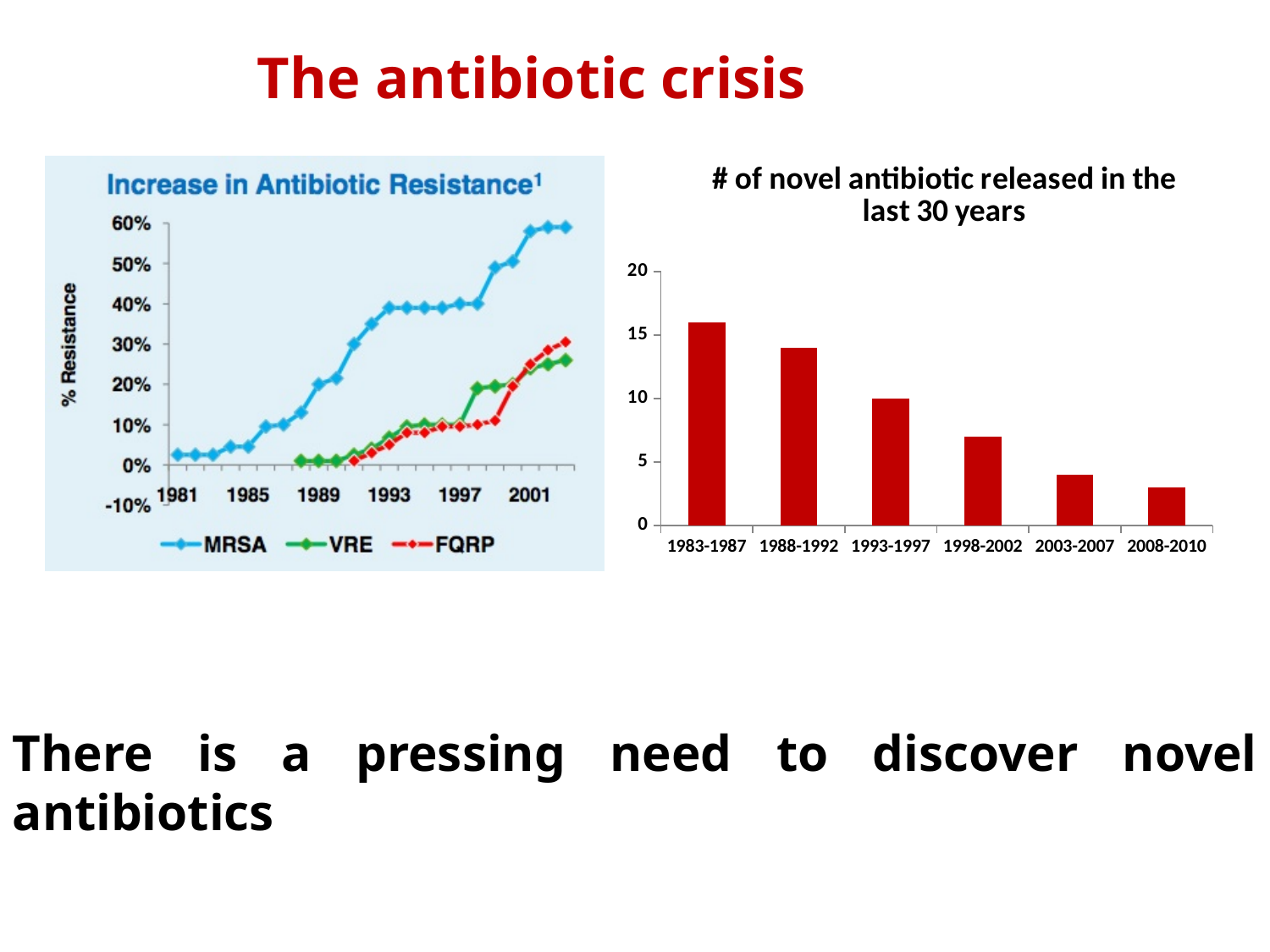
In the 'Increase in Antibiotic Resistance' chart, which series is drawn in blue? MRSA What kind of chart is the chart titled '# of novel antibiotic released in the last 30 years'? bar chart In the chart '# of novel antibiotic released in the last 30 years', which is larger, the value for 1988-1992 or the value for 1998-2002? 1988-1992 In the chart '# of novel antibiotic released in the last 30 years', how many time periods are shown on the x axis? 6 What kind of chart is the chart titled 'Increase in Antibiotic Resistance'? line chart In the chart '# of novel antibiotic released in the last 30 years', which period has the highest bar? 1983-1987 In the chart '# of novel antibiotic released in the last 30 years', is the value for 2003-2007 greater or less than 5? less In the chart '# of novel antibiotic released in the last 30 years', do the values rise or fall from left to right along the x axis? fall In the chart '# of novel antibiotic released in the last 30 years', which period has the lowest bar? 2008-2010 How many series does the legend of the 'Increase in Antibiotic Resistance' chart list? 3 In the chart '# of novel antibiotic released in the last 30 years', is the value for 1983-1987 greater or less than 15? greater